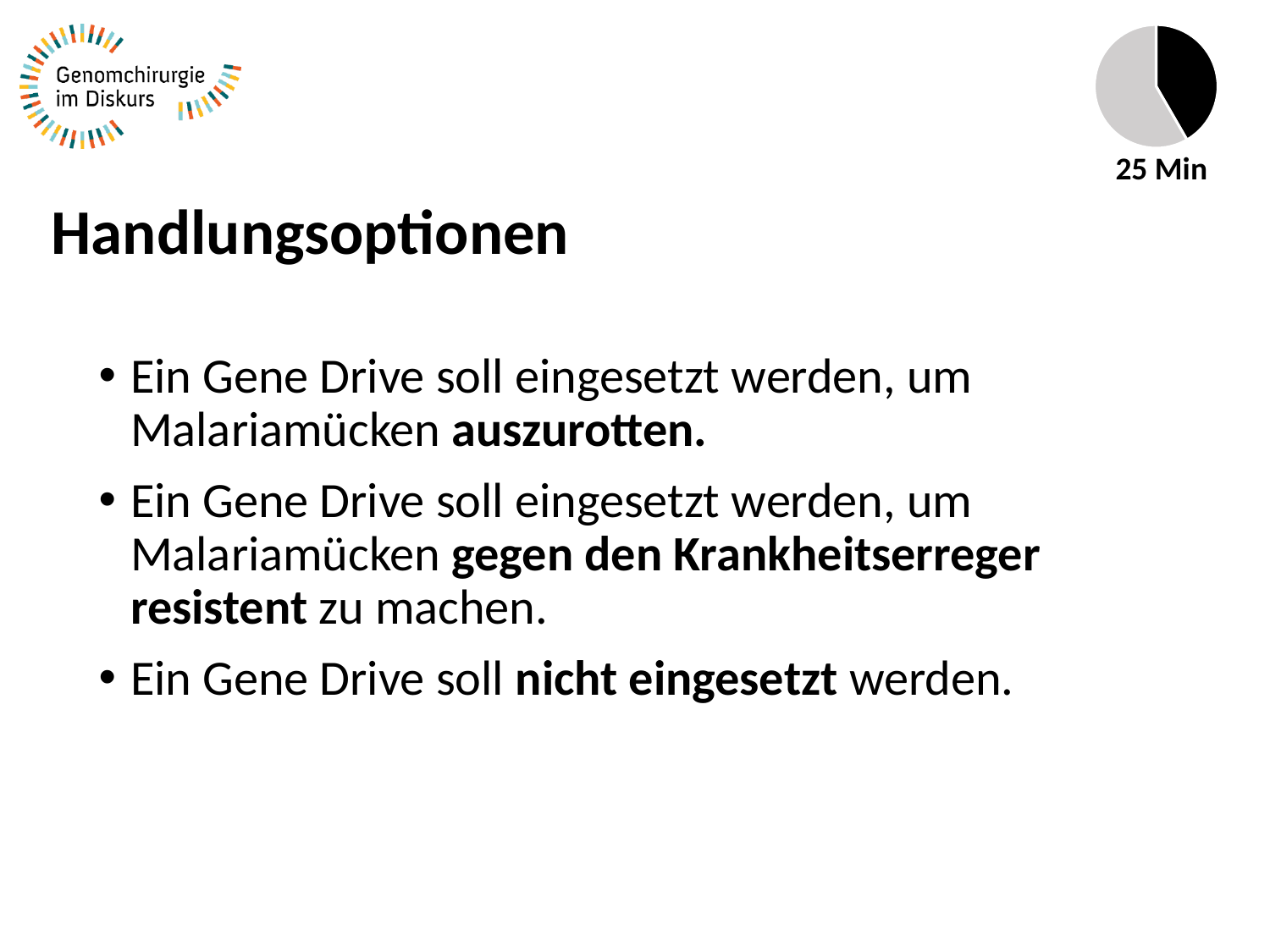
What label is printed directly below the pie chart in the top right corner? 25 Min Which slice of the pie chart in the top right corner is larger, the black one or the grey one? grey What two colours are used for the slices of the pie chart in the top right corner? black and grey What kind of chart is shown in the top right corner of the slide? pie chart How many slices does the pie chart in the top right corner have? 2